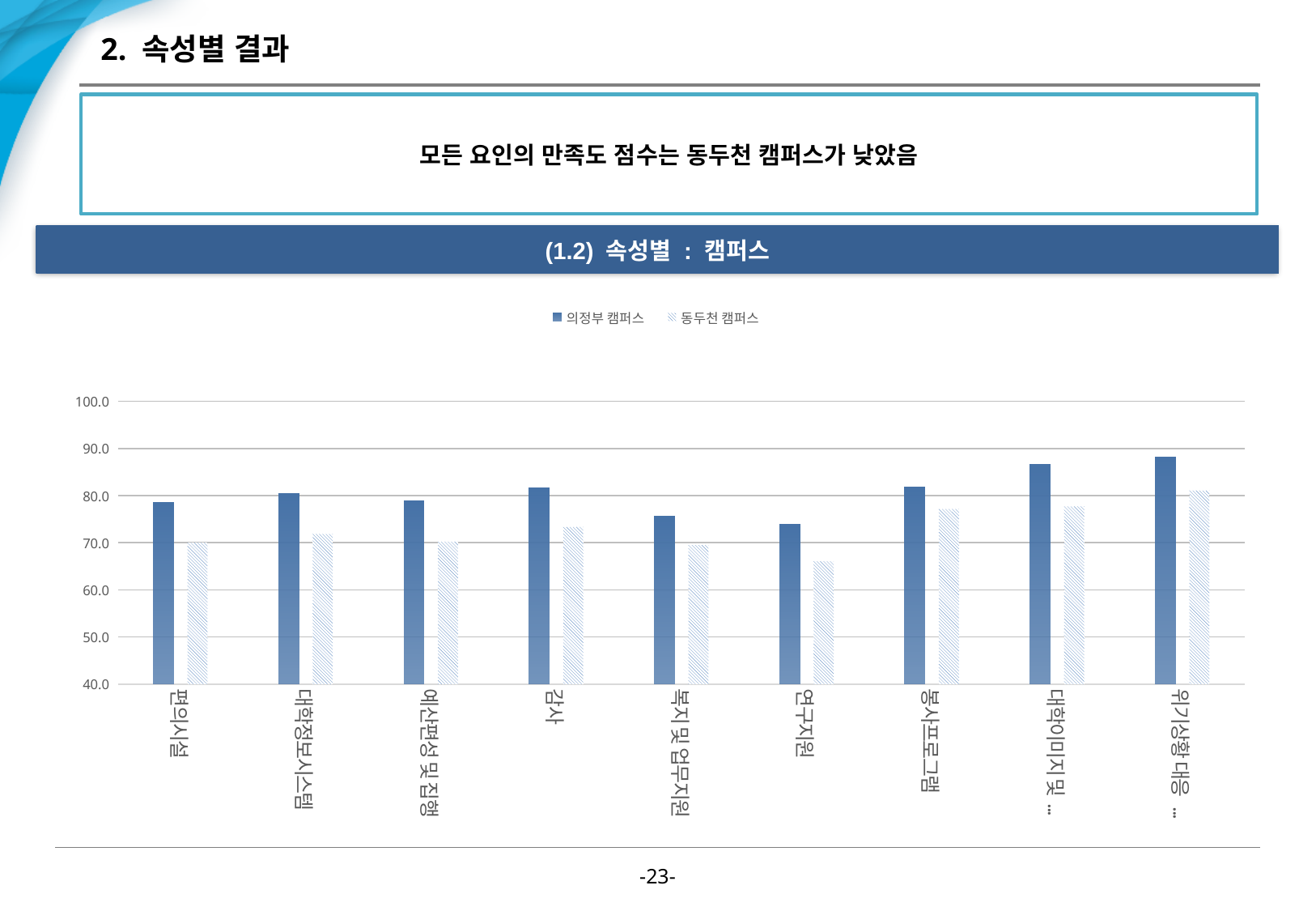
Is the value for 의정부 캠퍼스 in 편의시설 greater or less than 70? greater How many series does the legend list? 2 Which category has the lowest value for 동두천 캠퍼스? 연구지원 Which two series are listed in the chart legend? 의정부 캠퍼스, 동두천 캠퍼스 What kind of chart is shown on the slide? bar chart For 의정부 캠퍼스, which is larger, the value for 감사 or the value for 편의시설? 감사 Is the value for 동두천 캠퍼스 in 봉사프로그램 greater or less than 80? less For 연구지원, which campus has the larger value, 의정부 캠퍼스 or 동두천 캠퍼스? 의정부 캠퍼스 Is the value for 의정부 캠퍼스 in 연구지원 greater or less than 80? less How many categories are shown on the x axis of the chart? 9 Which category has the highest value for 동두천 캠퍼스? 위기상황 대응 …